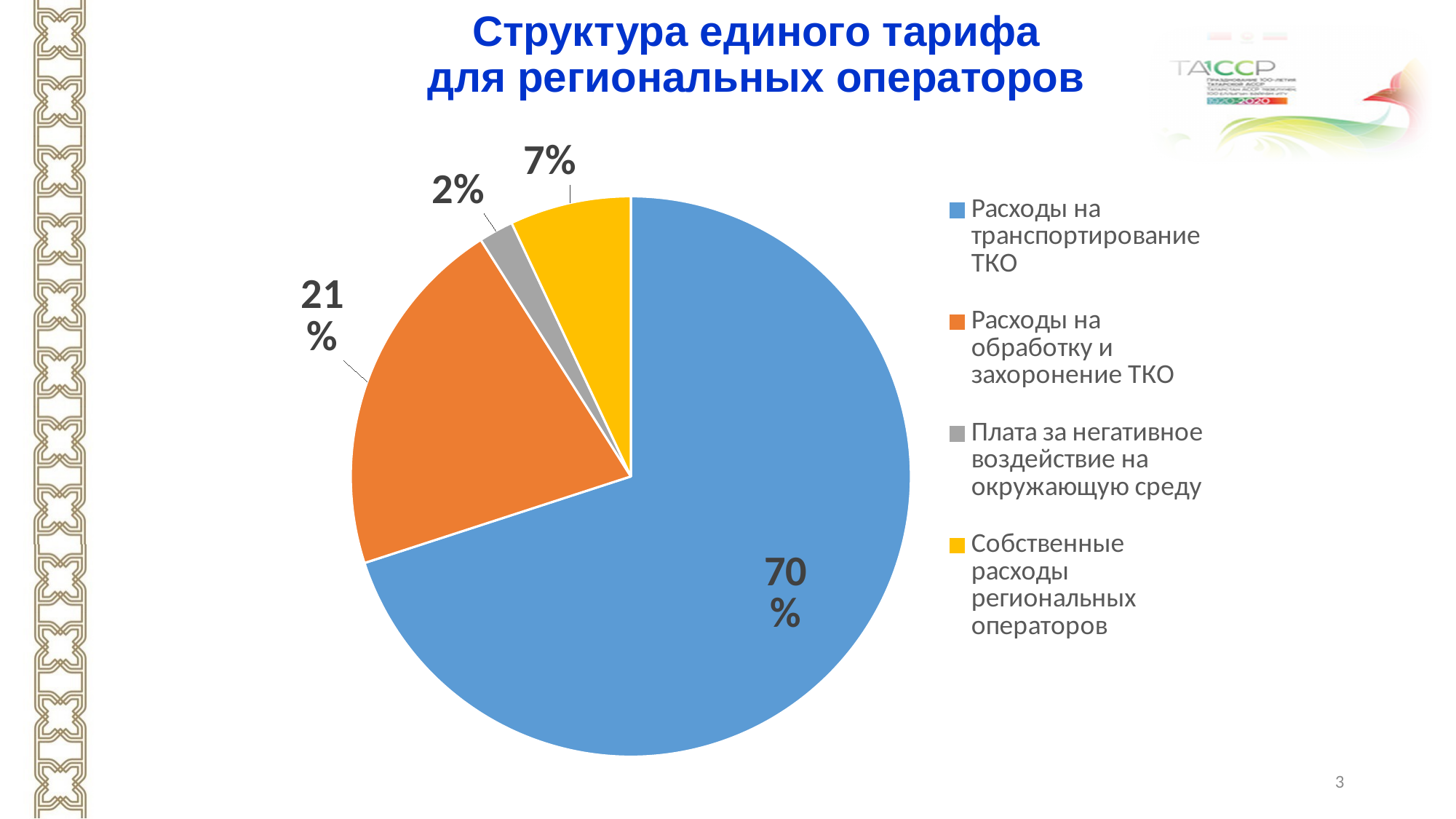
What share of the pie is 'Собственные расходы региональных операторов'? 7% Which category has the smallest slice of the pie? Плата за негативное воздействие на окружающую среду What share of the pie is 'Расходы на обработку и захоронение ТКО'? 21% What kind of chart is shown on the slide? pie chart Which category has the largest slice of the pie? Расходы на транспортирование ТКО What is the difference between the shares of 'Расходы на транспортирование ТКО' and 'Расходы на обработку и захоронение ТКО'? 49% What is the title of the chart on the slide? Структура единого тарифа для региональных операторов How many categories does the pie chart have? 4 What share of the pie is 'Расходы на транспортирование ТКО'? 70% What colour is the slice for 'Собственные расходы региональных операторов'? yellow Which is larger: the share of 'Собственные расходы региональных операторов' or the share of 'Плата за негативное воздействие на окружающую среду'? Собственные расходы региональных операторов